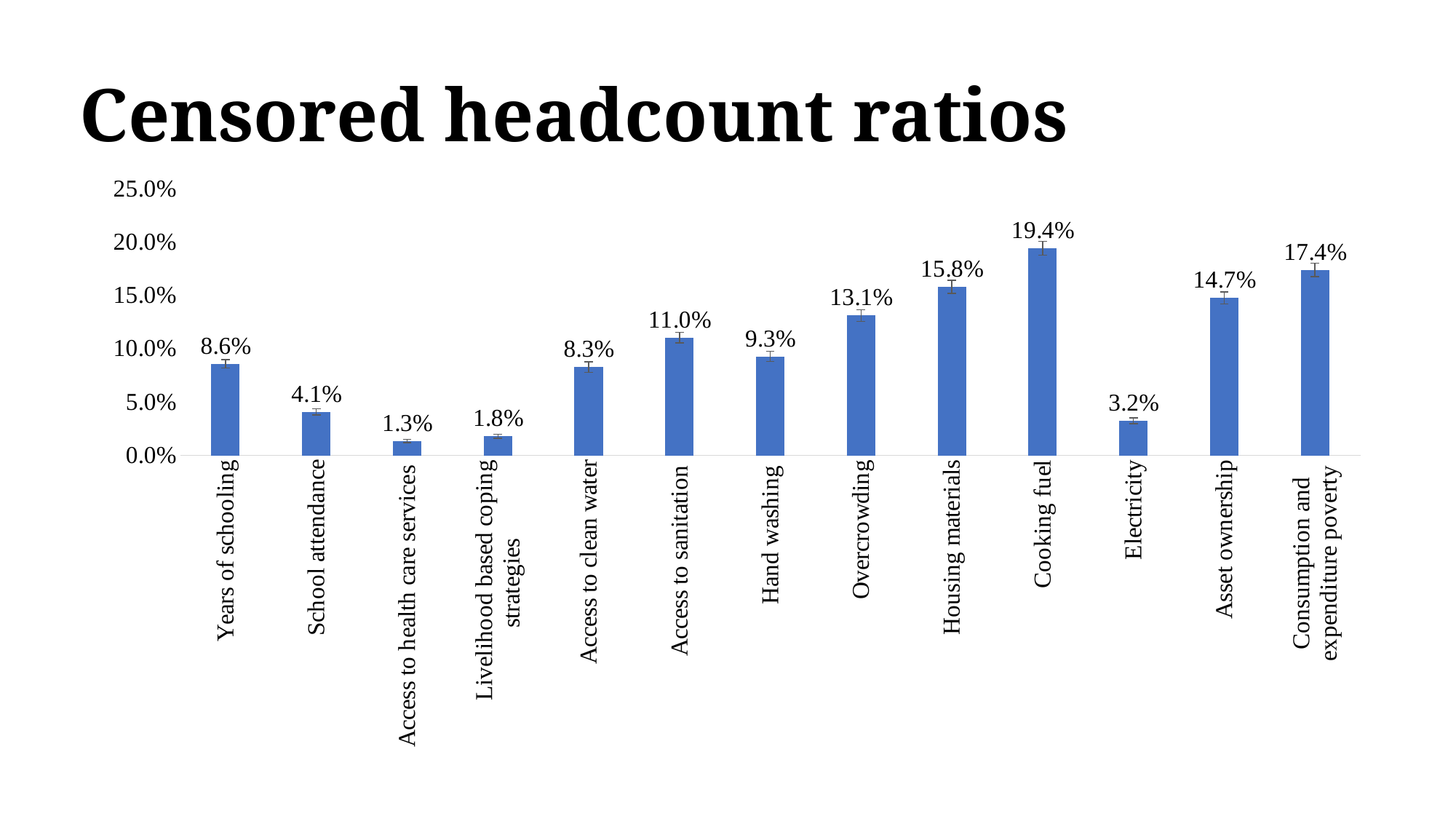
What is the value shown for Electricity? 3.2% Is the value for Access to sanitation greater or less than 10.0%? greater What kind of chart is shown on the slide? Bar chart Which is larger, the value for Hand washing or the value for Access to clean water? Hand washing What is the censored headcount ratio for Access to health care services? 1.3% What is the censored headcount ratio for Cooking fuel? 19.4% What is the difference between the values for Housing materials and Asset ownership? 1.1% What is the value shown for Overcrowding? 13.1% How many categories are shown on the chart? 13 Which category has the lowest censored headcount ratio? Access to health care services Which category has the highest censored headcount ratio? Cooking fuel What is the difference between the values for Cooking fuel and Consumption and expenditure poverty? 2.0%